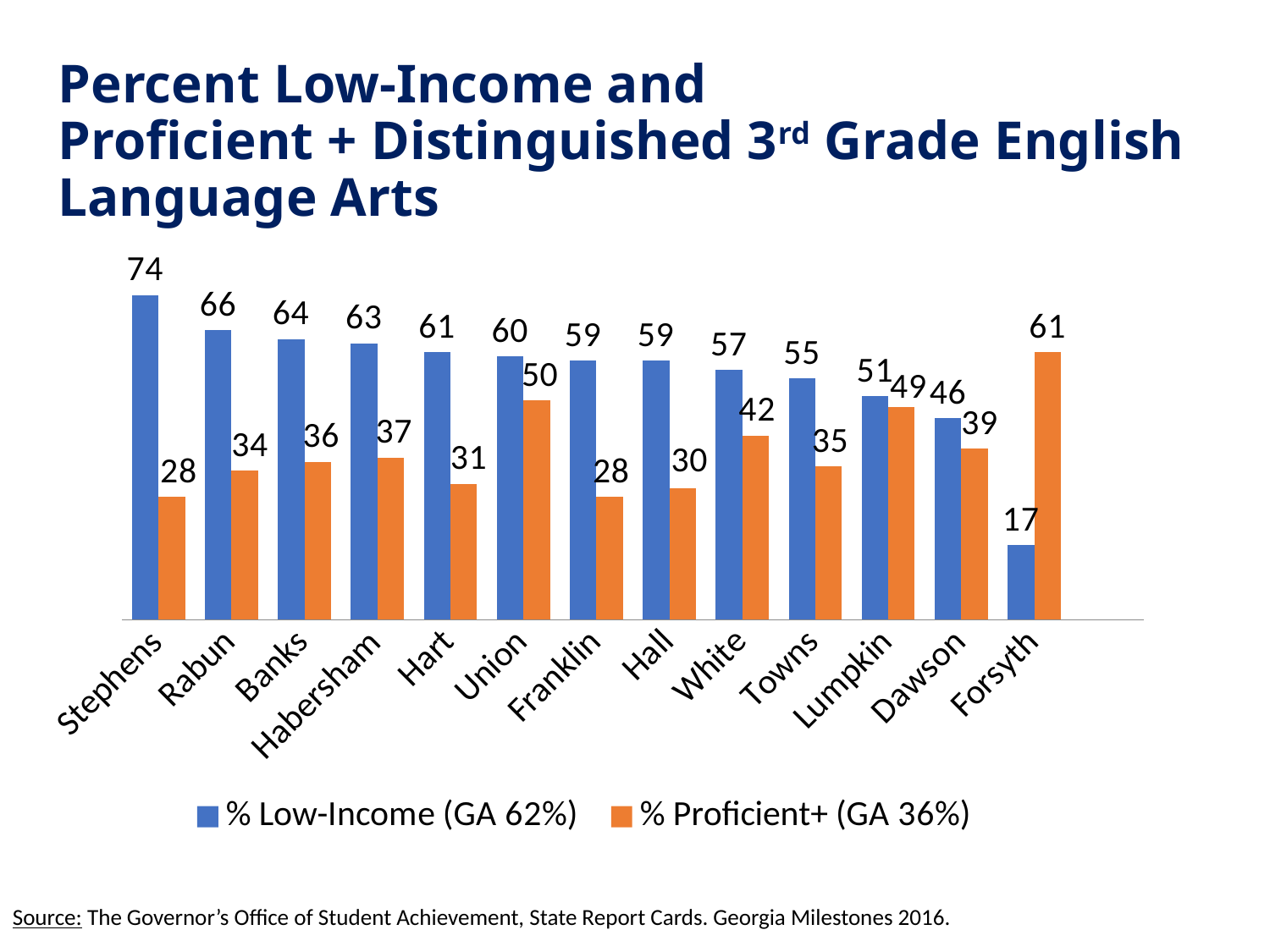
What is the % Proficient+ value for Union? 50 What is the % Proficient+ value for Forsyth? 61 What is the difference between the % Low-Income and % Proficient+ values for Stephens? 46 Which county has the highest % Proficient+ value? Forsyth What Georgia statewide value is given in the legend for % Proficient+? 36% What kind of chart is shown on the slide? Bar chart Which is larger for Forsyth, the % Low-Income value or the % Proficient+ value? % Proficient+ Which county has the lowest % Low-Income value? Forsyth Which county has the highest % Low-Income value? Stephens How many counties are shown on the x axis? 13 How many series does the legend list? 2 What is the % Low-Income value for Stephens? 74